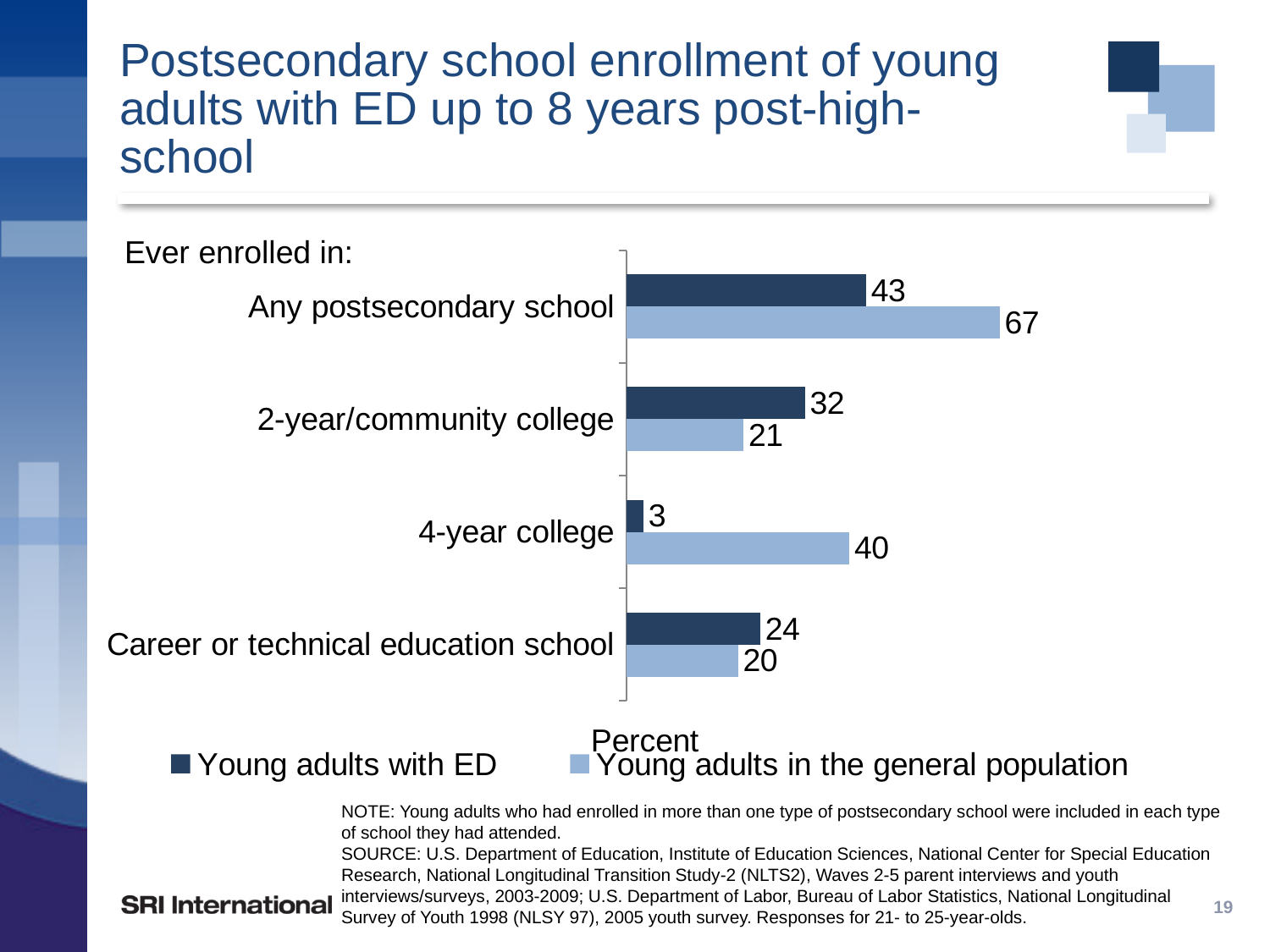
How many series does the legend list? 2 What is the value for young adults with ED for 2-year/community college? 32 What kind of chart is shown on the slide? Bar chart For 4-year college, which group has the larger value: young adults with ED or young adults in the general population? Young adults in the general population Which category has the lowest value for young adults with ED? 4-year college Which category has the highest value for young adults in the general population? Any postsecondary school What is the value for young adults in the general population for career or technical education school? 20 How many categories are shown on the chart? 4 What percent of young adults in the general population had ever enrolled in a 4-year college? 40 What is the difference between the general population and young adults with ED for any postsecondary school? 24 What percent of young adults with ED had ever enrolled in any postsecondary school? 43 What is the difference between young adults with ED and the general population for 2-year/community college? 11